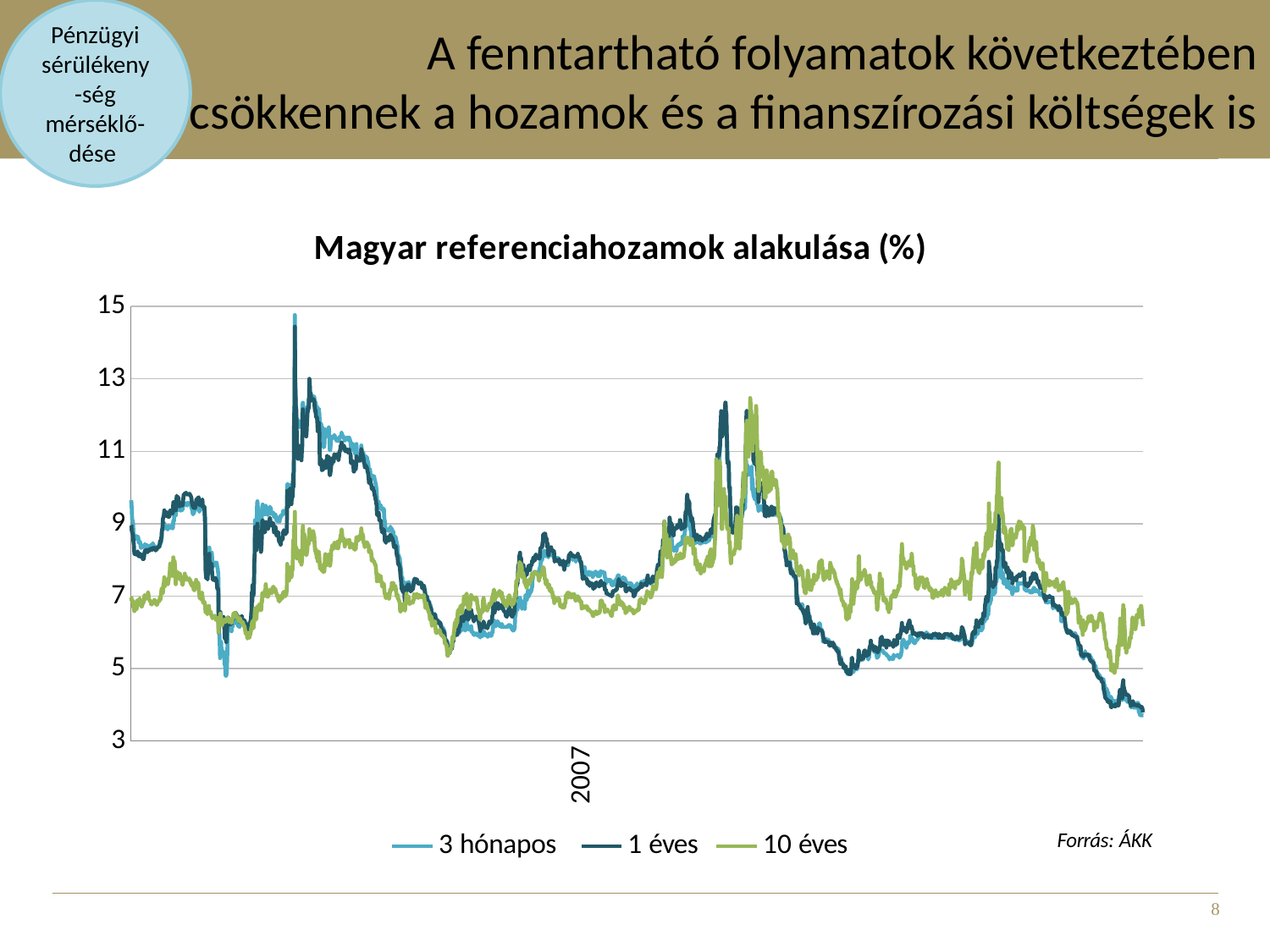
Which series are listed in the chart's legend? 3 hónapos, 1 éves, 10 éves What is the title of the chart? Magyar referenciahozamok alakulása (%) What is the highest value shown on the vertical axis of the chart? 15 Is the highest peak of the 10 éves series greater or less than 11? greater Which series reaches the highest peak on the chart, 1 éves or 10 éves? 1 éves Is the highest peak of the 1 éves series greater or less than 13? greater Does the 1 éves series overall rise or fall from the left end to the right end of the chart? fall Is the value of the 1 éves series at the right end of the chart greater or less than 5? less How many series does the legend of the chart list? 3 What kind of chart is shown on the slide? line chart Which series has the highest value at the right end of the chart? 10 éves